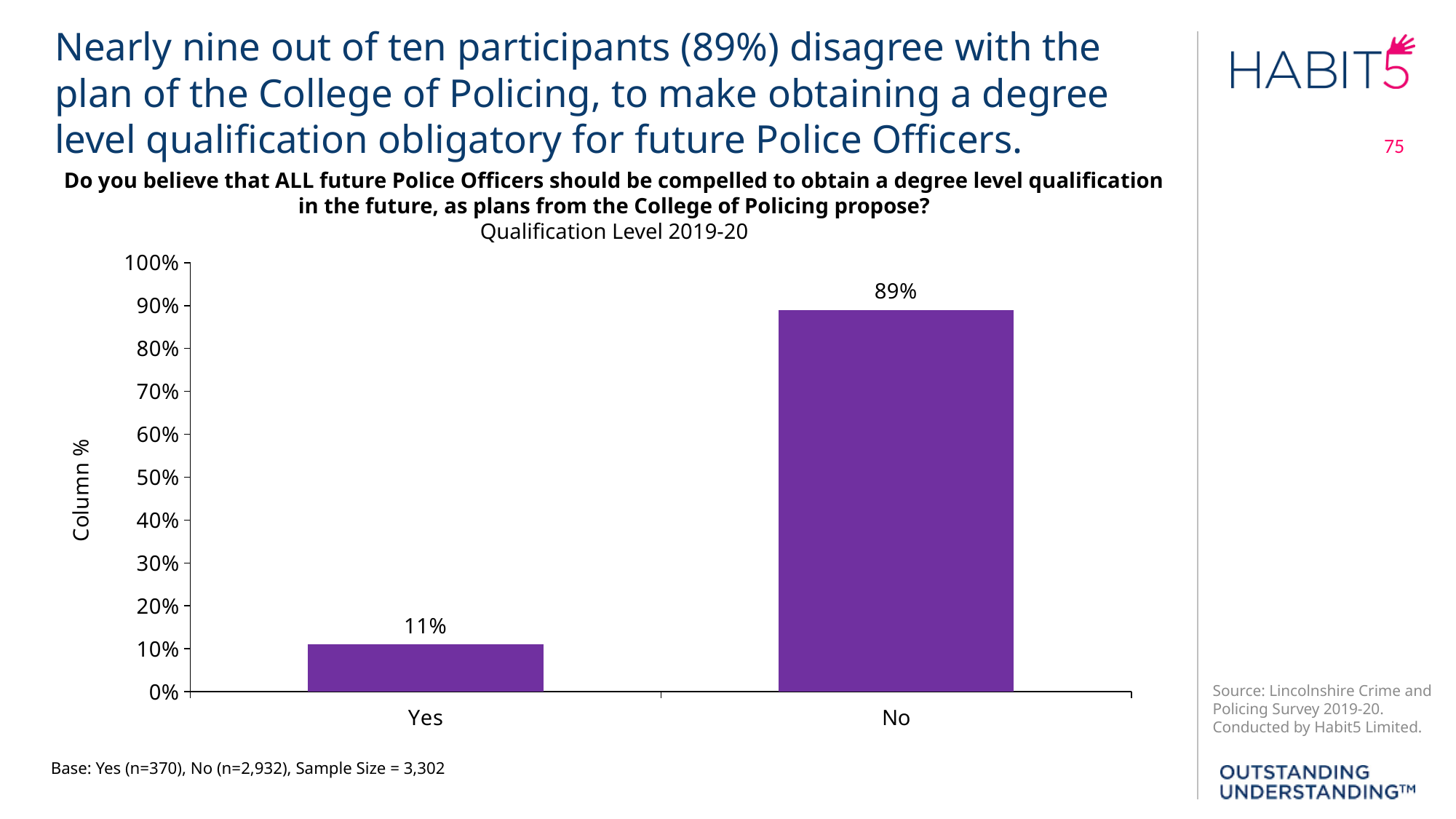
Which response category has the highest value? No How many response categories are shown on the x axis? 2 Which is larger, the value for Yes or the value for No? No What is the label of the y axis? Column % What is the maximum value shown on the y axis? 100% Which response category has the lowest value? Yes What percentage of participants answered Yes? 11% What is the difference in percentage points between the No and Yes responses? 78 percentage points Is the value for No greater or less than 80%? greater What kind of chart is shown on the slide? Bar chart Is the value for Yes greater or less than 20%? less What percentage of participants answered No? 89%